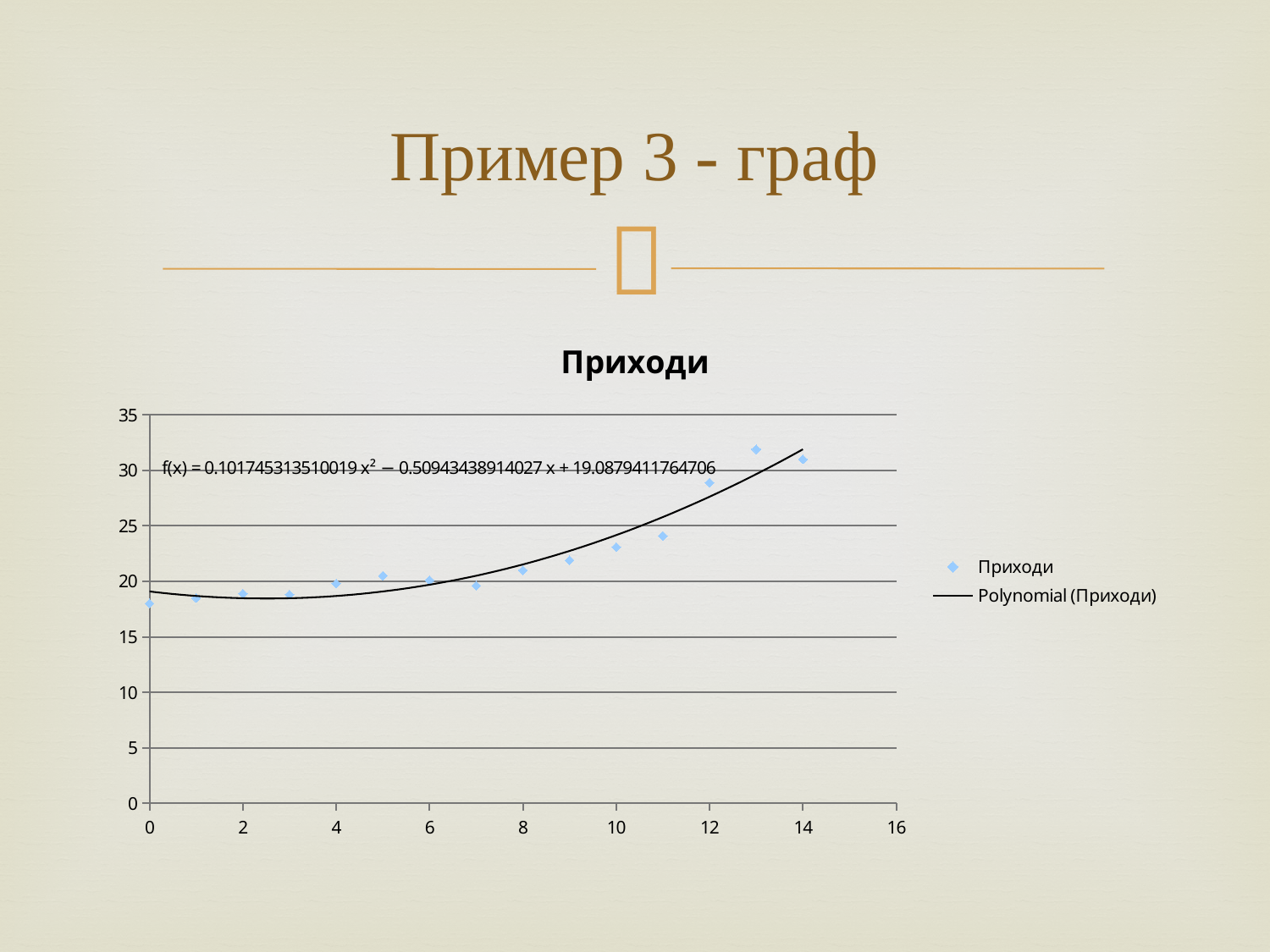
What is the title of the chart? Приходи How many entries does the chart legend list? 2 Is the Приходи value at x = 10 greater or less than 20? greater Do the Приходи values generally rise or fall as x increases from 0 to 14? rise What kind of chart is shown on the slide? scatter chart How many data points are plotted in the Приходи series? 15 Is the Приходи value at x = 4 greater or less than 25? less What is the name of the trendline entry in the legend? Polynomial (Приходи) Is the Приходи value at x = 0 greater or less than 20? less Which has the larger Приходи value, x = 12 or x = 4? x = 12